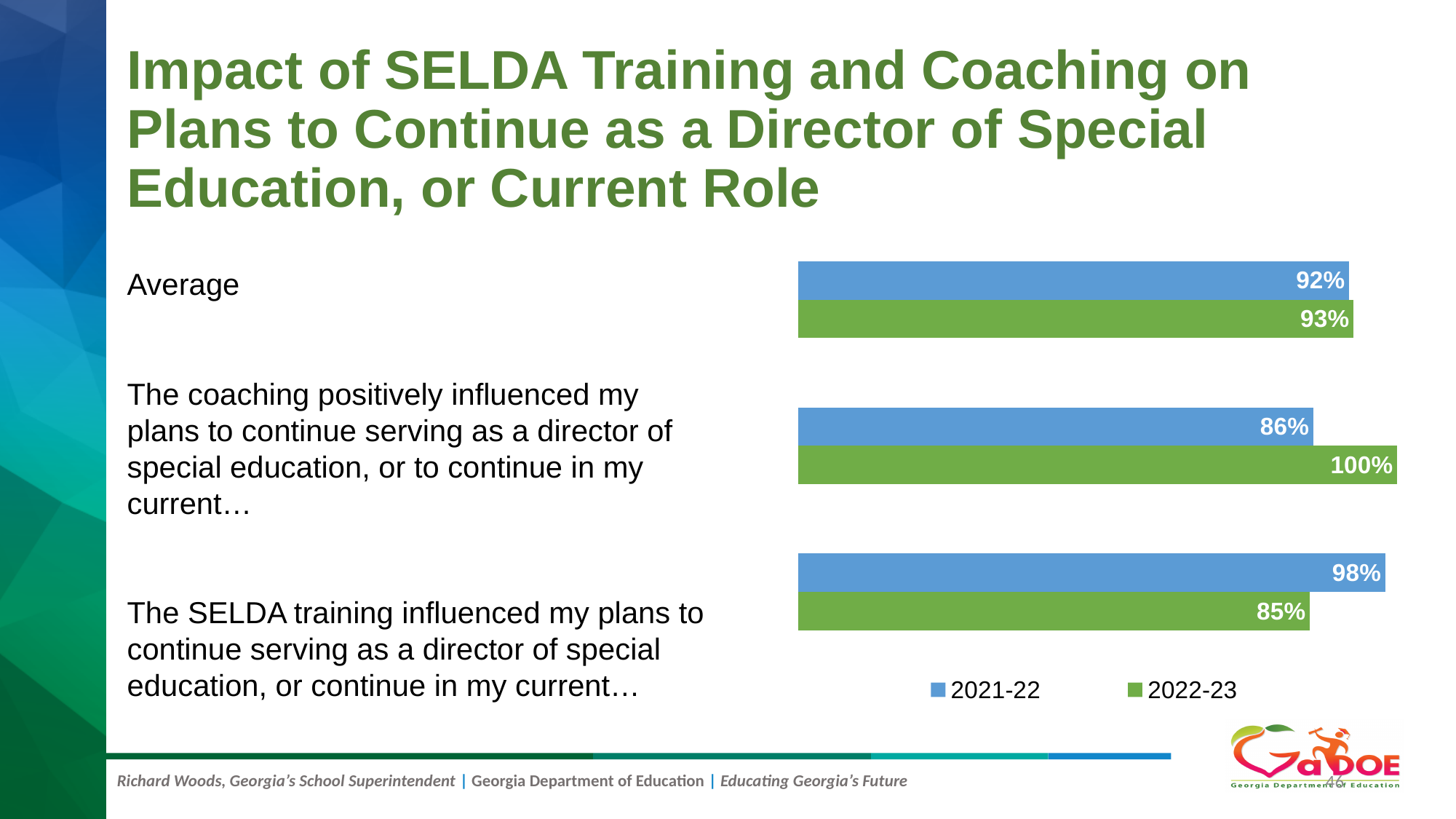
How many categories are plotted in the chart? 3 What is the 2022-23 value for the category beginning "The coaching positively influenced my plans"? 100% For the category beginning "The SELDA training influenced my plans", which series has the larger value, 2021-22 or 2022-23? 2021-22 What is the difference between the 2022-23 and 2021-22 values for the category beginning "The coaching positively influenced my plans"? 14% What is the 2021-22 value for Average? 92% Which category has the lowest 2021-22 value? The coaching positively influenced my plans to continue serving as a director of special education, or to continue in my current… What kind of chart is shown on the slide? bar chart What is the 2021-22 value for the category beginning "The SELDA training influenced my plans"? 98% Which category has the highest 2022-23 value? The coaching positively influenced my plans to continue serving as a director of special education, or to continue in my current… How many series does the legend list? 2 What is the 2022-23 value for Average? 93% Which colour represents the 2022-23 series in the chart? green